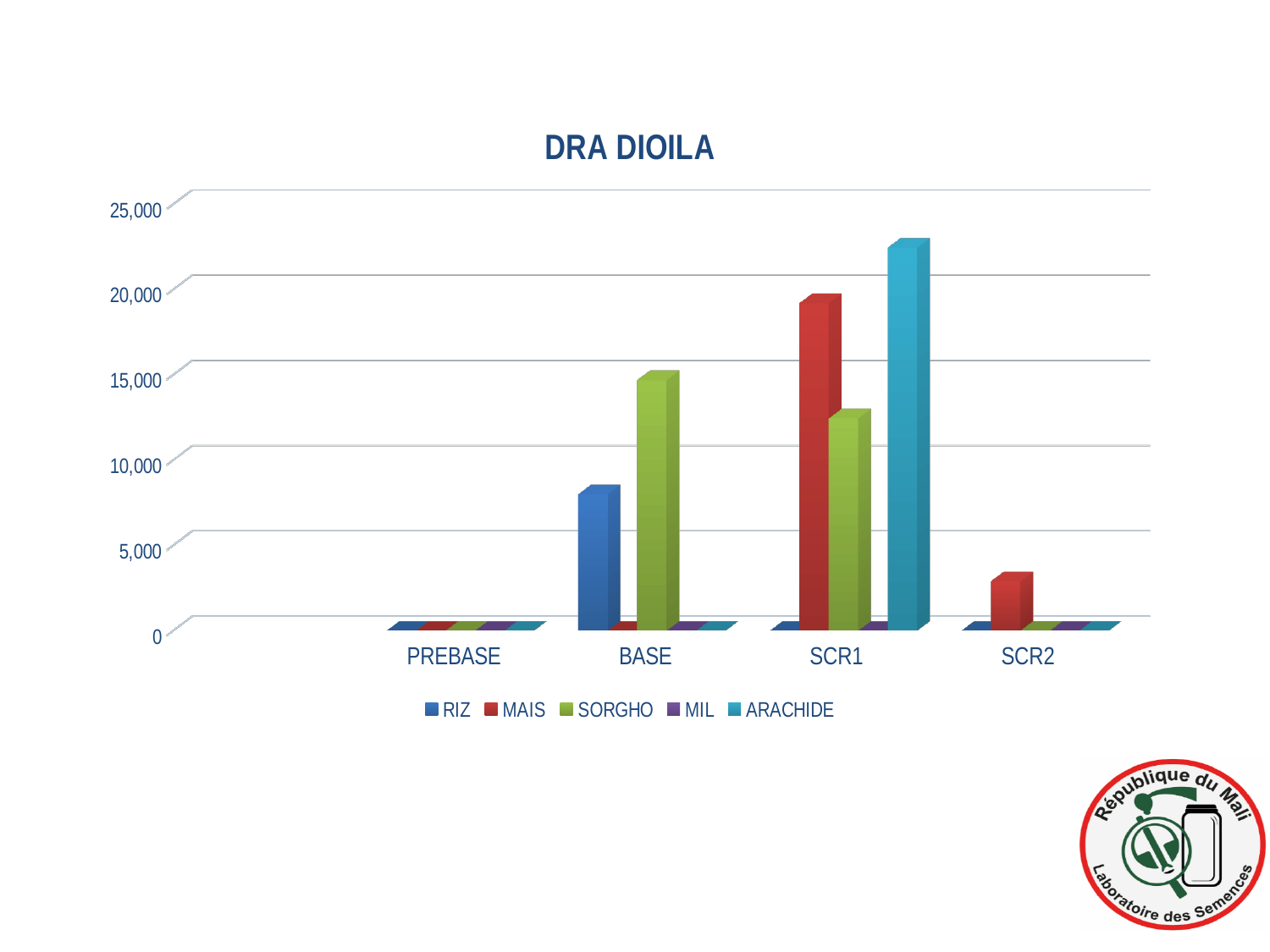
Which series has the tallest bar in the BASE category? SORGHO Is the value for SORGHO in BASE greater or less than 10,000? greater Which series has the tallest bar in the SCR1 category? ARACHIDE How many series does the legend list? 5 Is the value for ARACHIDE in SCR1 greater or less than 20,000? greater In the SCR1 category, which is larger, the MAIS bar or the SORGHO bar? MAIS What is the title of the chart? DRA DIOILA What kind of chart is shown on the slide? bar chart Which series is shown in red in the legend? MAIS Is the value for RIZ in BASE greater or less than 10,000? less How many categories are shown on the x axis? 4